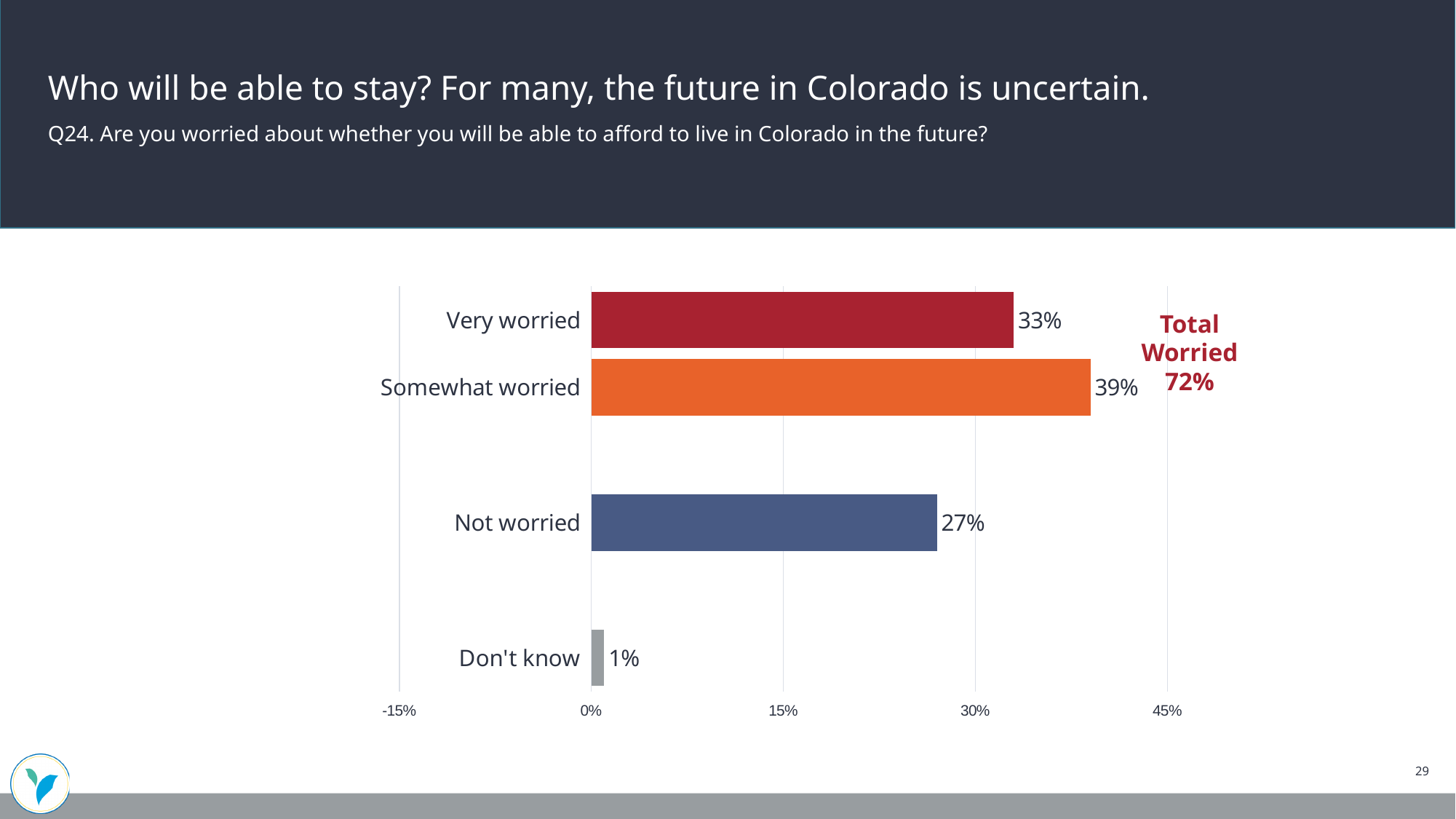
How many response categories are shown in the chart? 4 What type of chart is shown on the slide? Bar chart Which response category has the highest percentage? Somewhat worried Which response category has the lowest percentage? Don't know What percentage of respondents said they are not worried? 27% Is the value for 'Very worried' greater or less than 30%? greater What percentage of respondents answered 'Don't know'? 1% What is the difference in percentage points between 'Somewhat worried' and 'Not worried'? 12 What percentage of respondents said they are very worried about being able to afford to live in Colorado in the future? 33% What 'Total Worried' percentage is annotated on the chart? 72% Which is larger, the percentage for 'Very worried' or for 'Not worried'? Very worried What percentage of respondents said they are somewhat worried? 39%